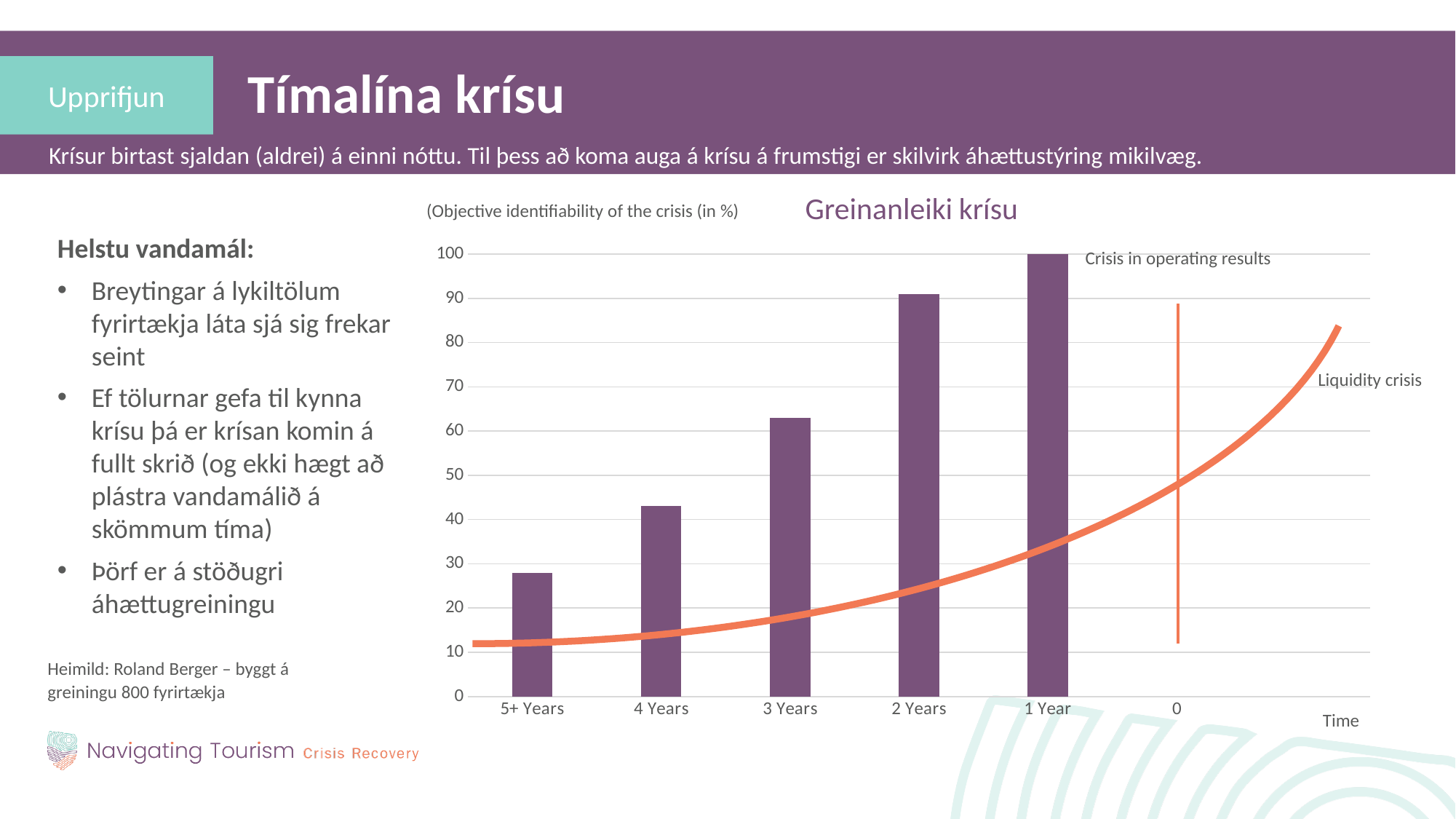
Is the value for 4 Years greater or less than 40? greater Is the value for 1 Year greater or less than 90? greater How many bars are plotted in the chart? 5 Is the value for 5+ Years greater or less than 30? less Do the bar values rise or fall from 5+ Years to 1 Year? rise What is the title of the chart? Greinanleiki krísu What kind of chart is shown under the title "Greinanleiki krísu"? bar chart Which is larger, the bar for 2 Years or the bar for 3 Years? 2 Years Which category has the tallest bar? 1 Year Which category has the shortest bar? 5+ Years